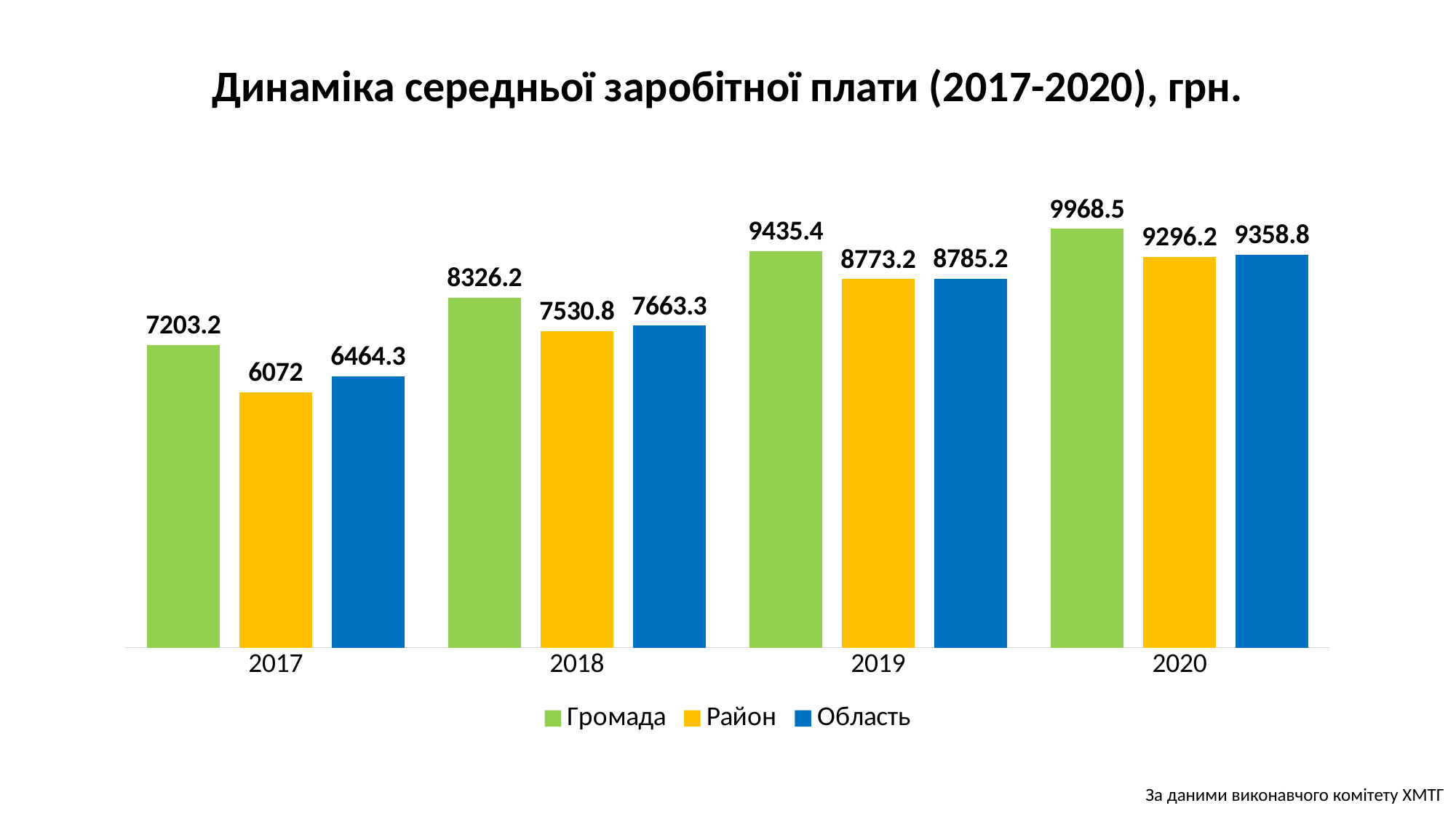
In which year is the value for Громада highest? 2020 Which is larger in 2018: the value for Громада or the value for Область? Громада How many years are shown on the x axis? 4 What is the difference between the Громада and Район values in 2020? 672.3 In which year is the value for Область lowest? 2017 Do the values for Громада rise or fall from 2017 to 2020? rise How many series does the legend list? 3 What is the value for Район in 2017? 6072 What is the difference between the Громада and Район values in 2017? 1131.2 What is the value for Область in 2020? 9358.8 What is the value for Громада in 2019? 9435.4 What kind of chart is shown on the slide? bar chart